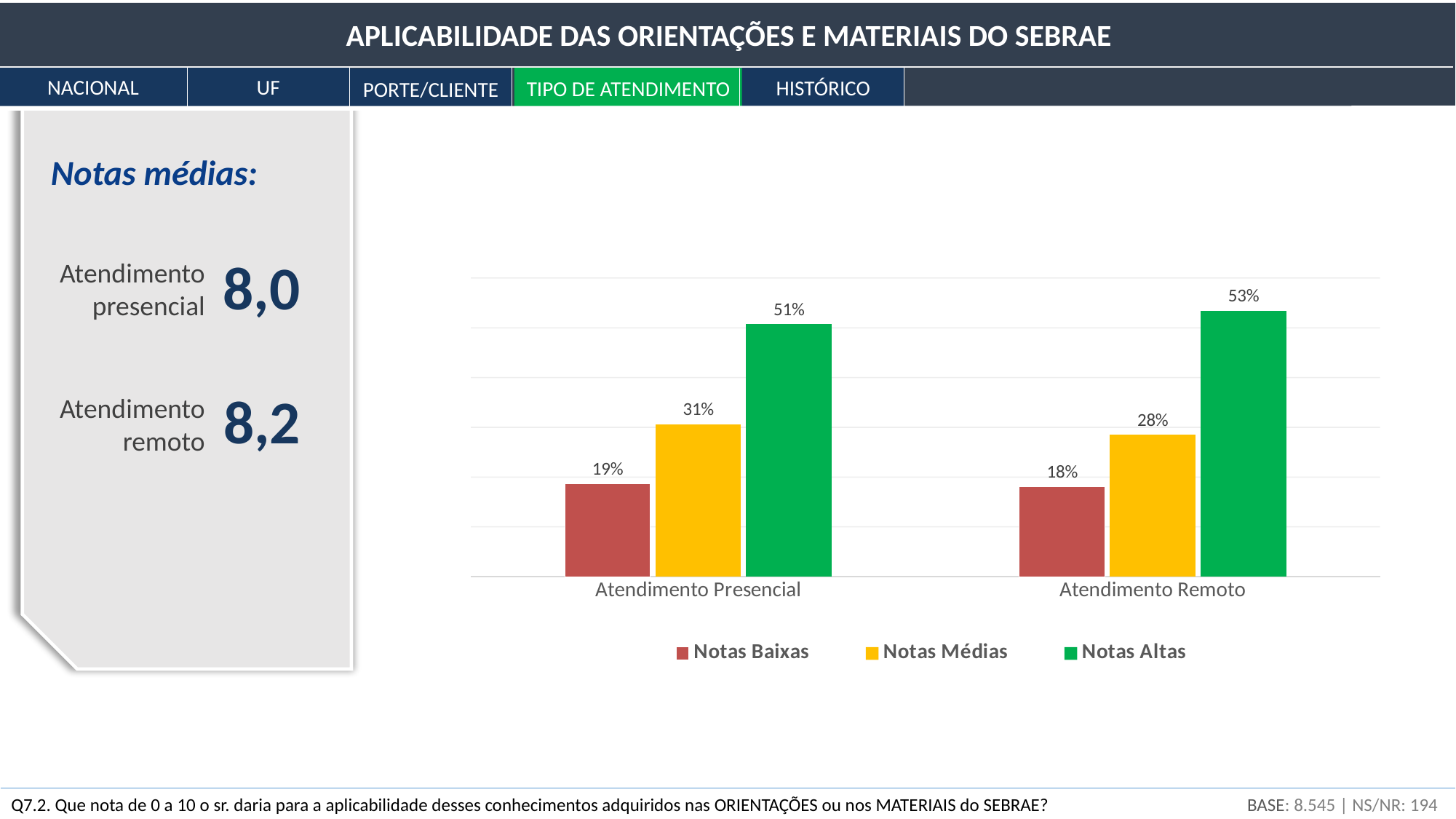
Which series has the lowest value in the Atendimento Presencial category? Notas Baixas What is the value for Notas Médias in the Atendimento Presencial category? 31% What is the value for Notas Altas in the Atendimento Presencial category? 51% How many series does the chart legend list? 3 What is the value for Notas Altas in the Atendimento Remoto category? 53% How many categories are shown on the x axis of the chart? 2 What is the difference between Notas Médias for Atendimento Presencial and Atendimento Remoto? 3% What is the value for Notas Baixas in the Atendimento Remoto category? 18% Which is larger: Notas Altas for Atendimento Presencial or Notas Altas for Atendimento Remoto? Atendimento Remoto What kind of chart is shown on the slide? Bar chart What is the difference between Notas Altas and Notas Médias in the Atendimento Presencial category? 20% Which series has the highest value in the Atendimento Remoto category? Notas Altas